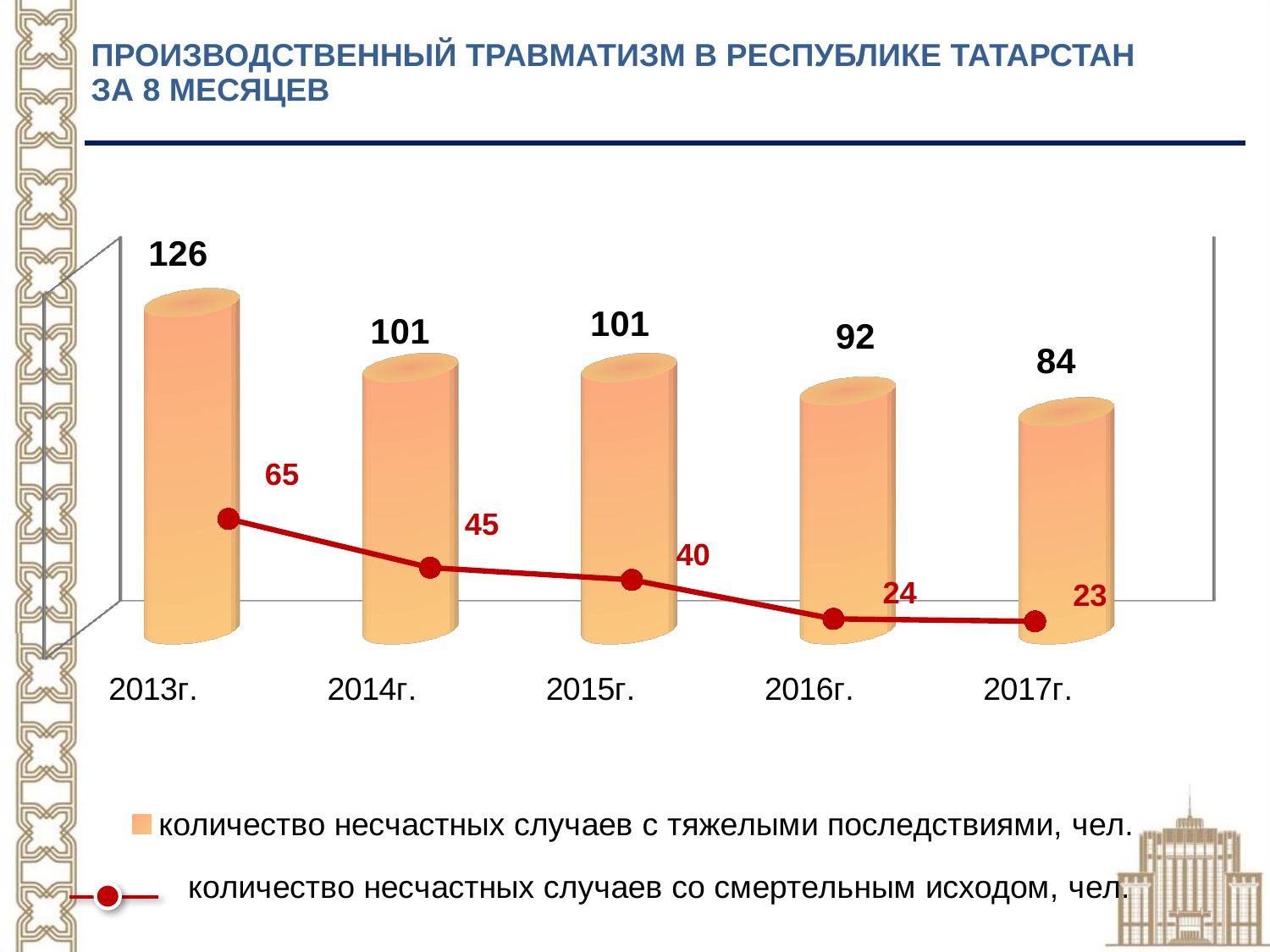
What is the difference between the number of accidents with severe consequences in 2013г. and 2017г.? 42 What is the difference between the number of fatal accidents in 2013г. and 2014г.? 20 What is the number of accidents with severe consequences in 2017г.? 84 Which year has the highest number of accidents with severe consequences? 2013г. Do the fatal accident values rise or fall from 2013г. to 2017г.? fall Which is larger: the number of accidents with severe consequences in 2016г. or in 2017г.? 2016г. What kind of chart is used for the number of accidents with severe consequences? bar chart How many series does the legend list? 2 What is the number of accidents with severe consequences (количество несчастных случаев с тяжелыми последствиями) in 2013г.? 126 How many years are shown on the x axis? 5 What is the number of fatal accidents (количество несчастных случаев со смертельным исходом) in 2015г.? 40 Which year has the lowest number of fatal accidents? 2017г.